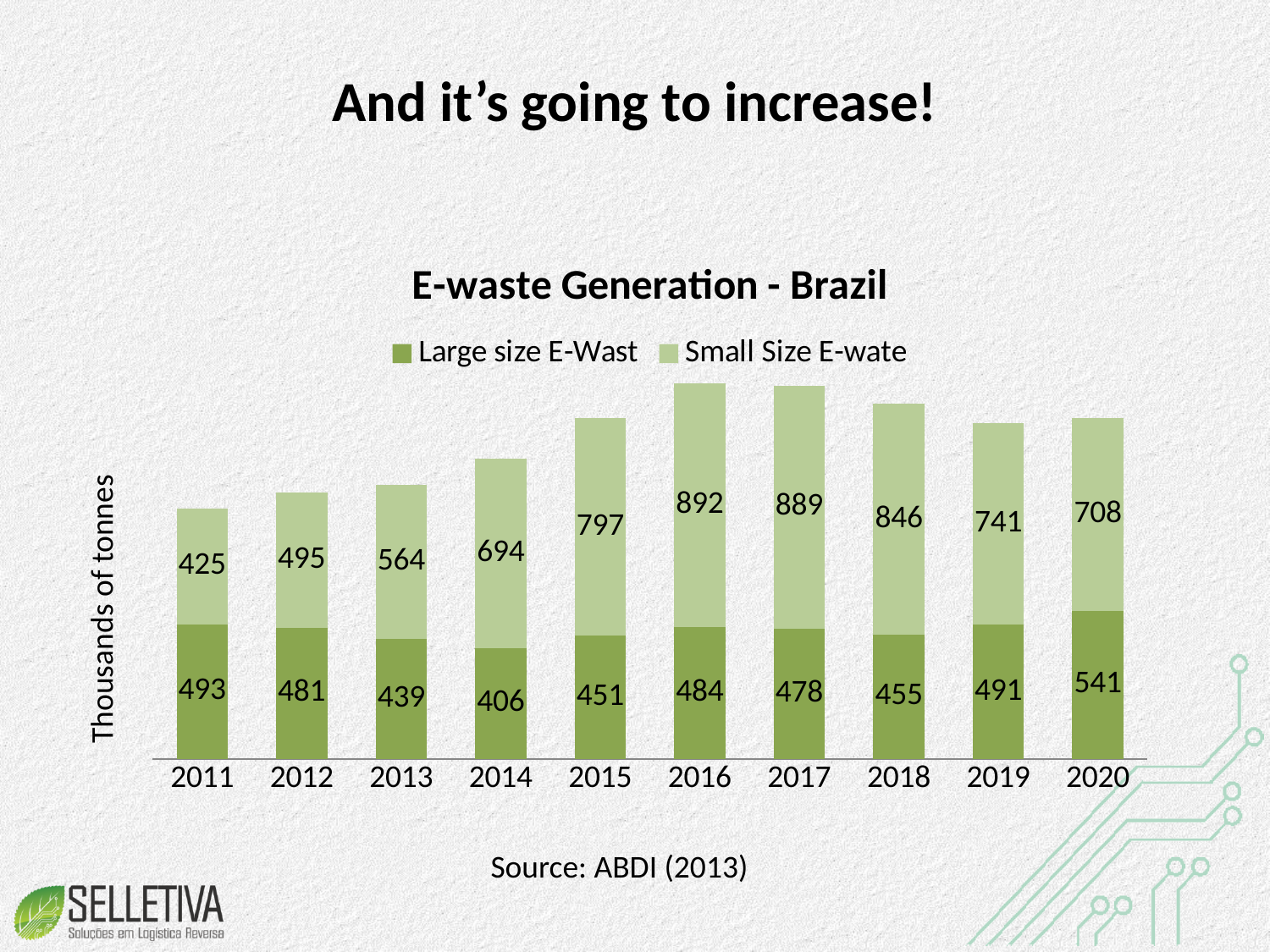
What is the value for Large size E-Wast in 2013? 439 Which is larger: the Large size E-Wast value in 2019 or in 2018? 2019 What is the value for Small Size E-wate in 2015? 797 What is the total of the stacked bar for 2020? 1249 In which year is the Large size E-Wast value the lowest? 2014 What is the difference between the Small Size E-wate values for 2016 and 2011? 467 What is the title of the chart? E-waste Generation - Brazil How many series does the legend list? 2 In which year is the Large size E-Wast value the highest? 2020 In which year is the Small Size E-wate value the highest? 2016 What type of chart is shown on the slide? Stacked bar chart How many years are shown on the x axis? 10